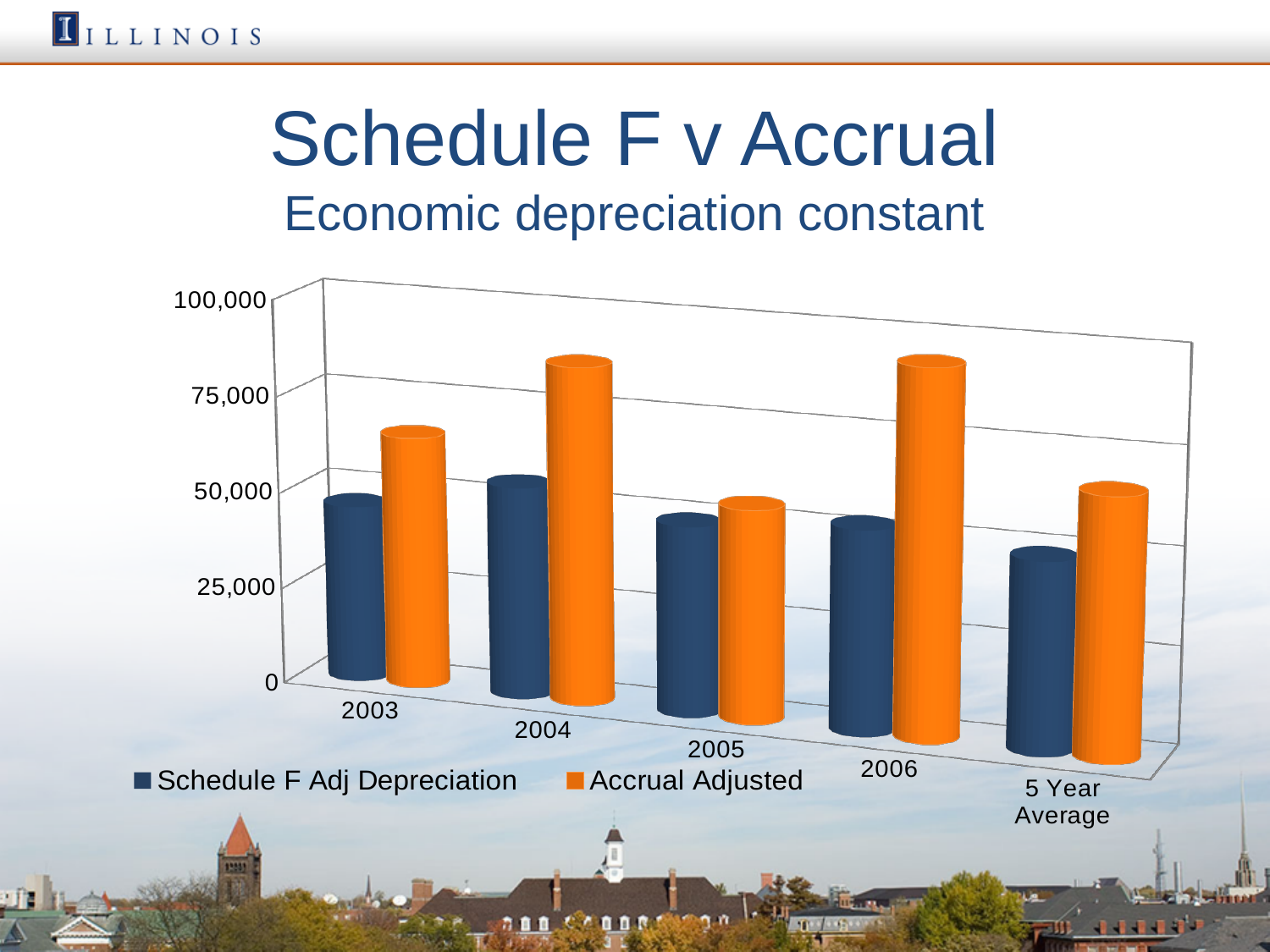
Which category has the lowest Schedule F Adj Depreciation value? 2003 Is the Accrual Adjusted value for 2004 greater or less than 50,000? greater Is the Schedule F Adj Depreciation value for 2003 greater or less than 75,000? less Which category has the lowest Accrual Adjusted value? 2005 What colour are the Accrual Adjusted bars? orange What kind of chart is shown on the slide? bar chart Which category has the highest Schedule F Adj Depreciation value? 2004 How many categories are shown along the x axis? 5 How many series does the legend list? 2 For 2006, which is larger: Schedule F Adj Depreciation or Accrual Adjusted? Accrual Adjusted Which is larger: the Accrual Adjusted value for 2003 or for 2005? 2003